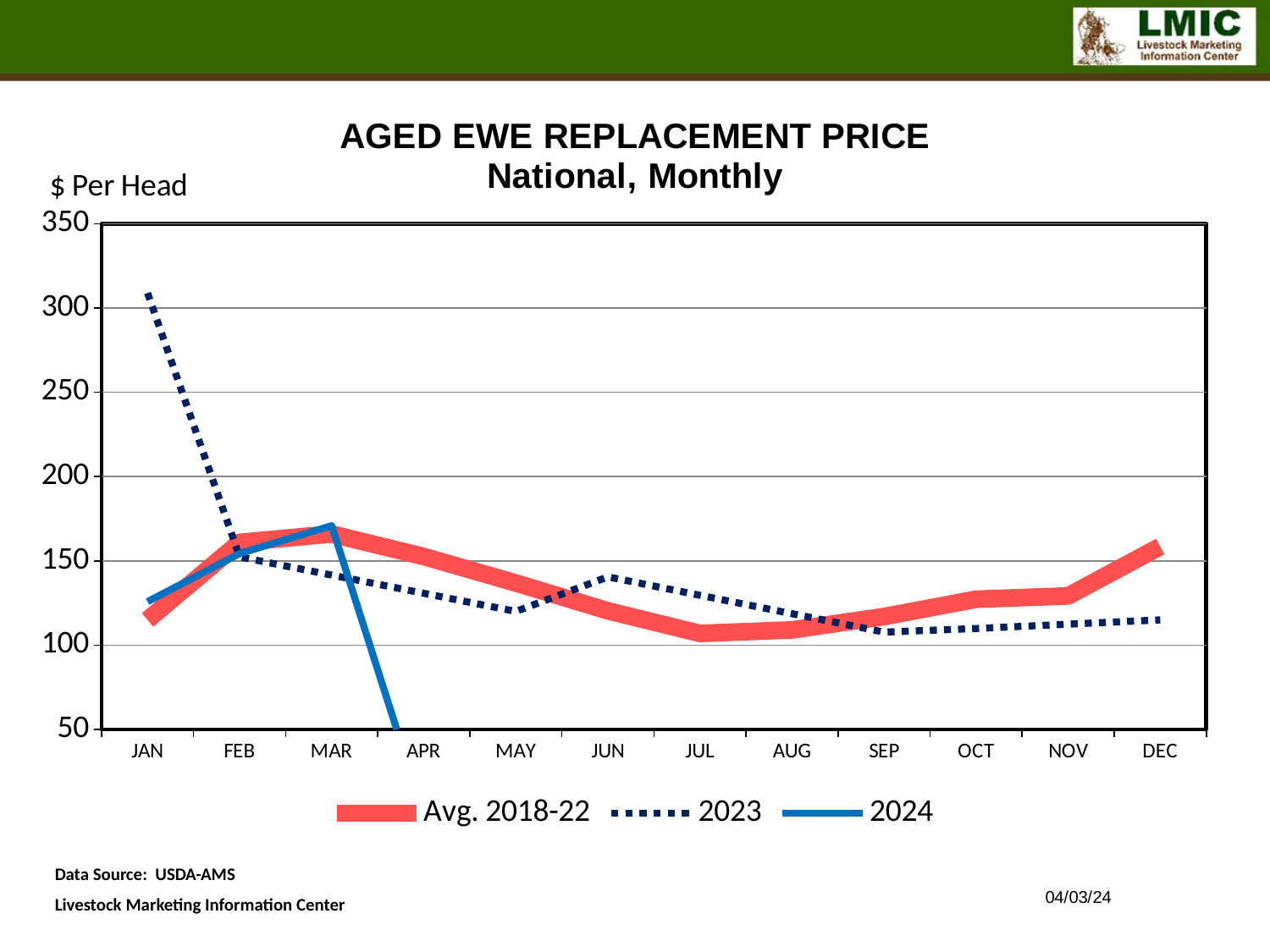
Is the 2023 value for JAN greater or less than 250? greater In which month is the Avg. 2018-22 series at its highest? MAR In which month is the 2023 series at its highest? JAN Which is larger in JAN, the 2023 value or the Avg. 2018-22 value? 2023 What kind of chart is shown on the slide? line chart How many months are shown along the x axis? 12 Which is larger in DEC, the Avg. 2018-22 value or the 2023 value? Avg. 2018-22 How many series does the legend list? 3 Does the 2023 series rise or fall from JAN to MAR? fall What is the label on the y axis of the chart? $ Per Head Is the 2024 value for MAR greater or less than 150? greater Is the Avg. 2018-22 value for JUL greater or less than 150? less